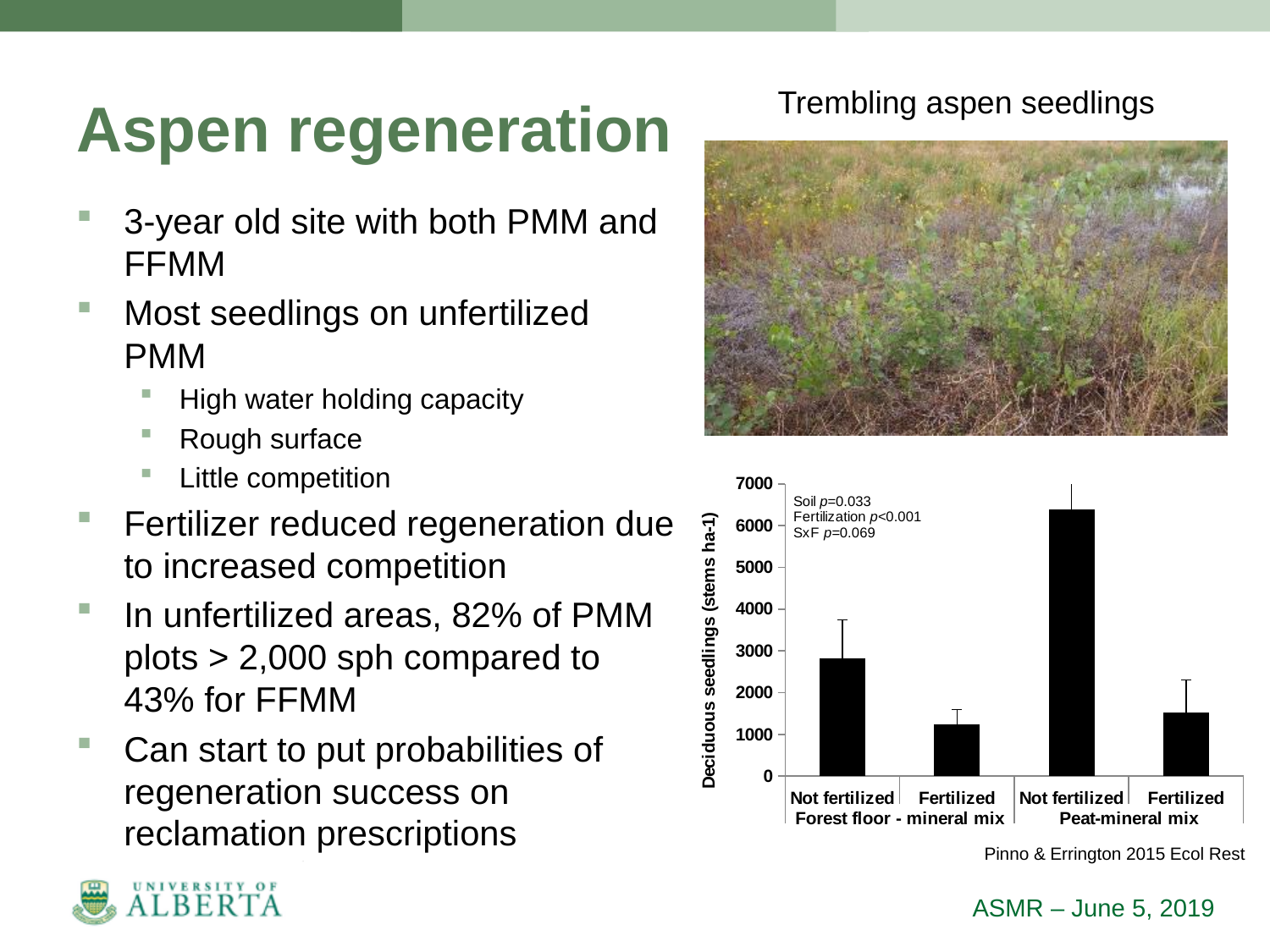
Is the value for Fertilized Peat-mineral mix greater or less than 2000? less Within Forest floor - mineral mix, which is larger: Not fertilized or Fertilized? Not fertilized What kind of chart is shown at the bottom right of the slide? bar chart How many bars are plotted in the chart? 4 What is the label of the y axis of the chart? Deciduous seedlings (stems ha-1) Is the value for Not fertilized Forest floor - mineral mix greater or less than 2000? greater Is the value for Fertilized Forest floor - mineral mix greater or less than 2000? less Which is larger: the Not fertilized bar for Peat-mineral mix or the Not fertilized bar for Forest floor - mineral mix? Not fertilized, Peat-mineral mix What p-value is given for Fertilization in the chart annotation? p<0.001 Which bar has the highest number of deciduous seedlings? Not fertilized, Peat-mineral mix Within Peat-mineral mix, does the value fall or rise from Not fertilized to Fertilized? fall